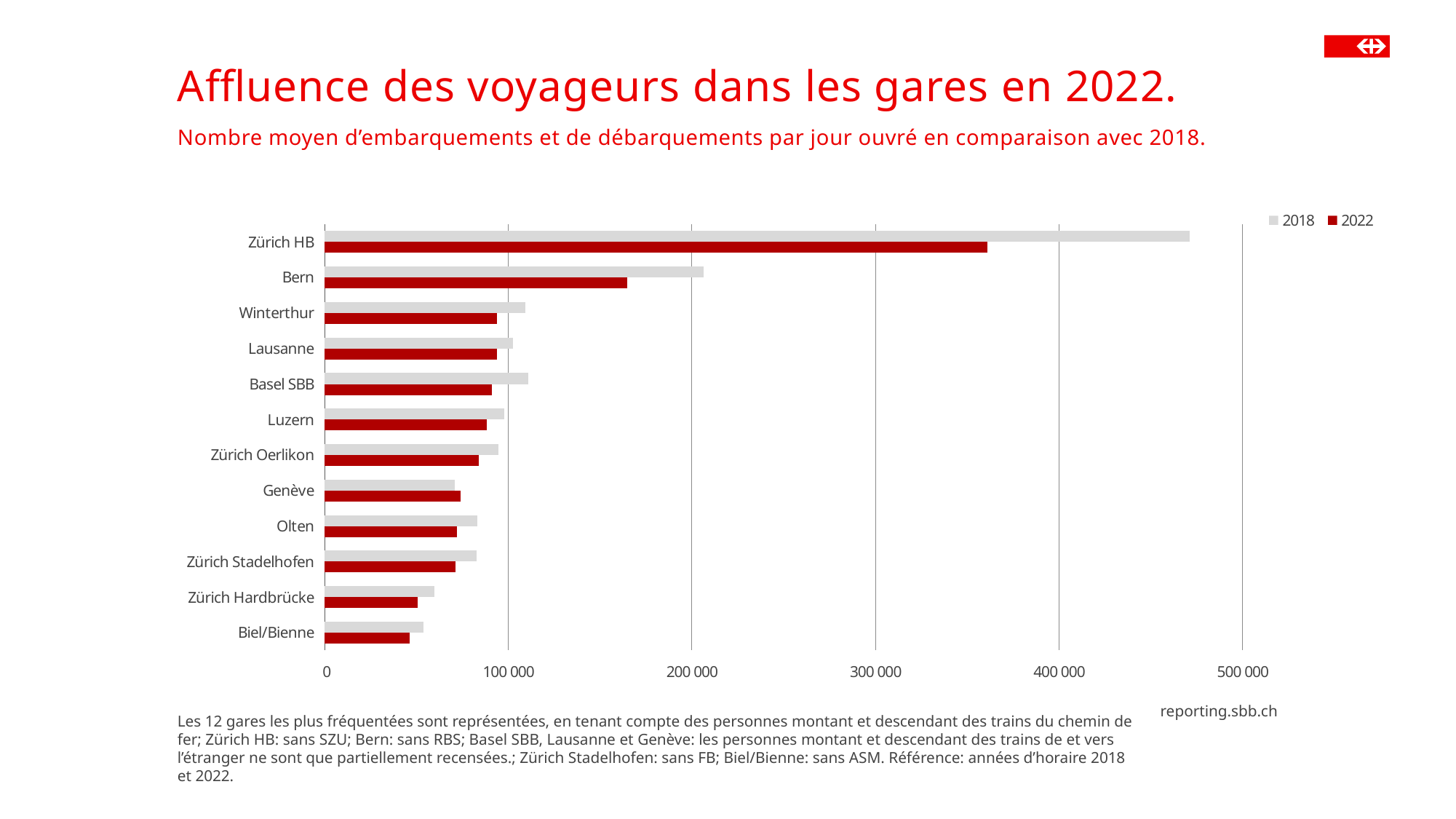
Which station has the lowest value for 2018? Biel/Bienne How many stations are listed on the chart? 12 How many series does the legend list? 2 Which station has the highest value for 2022? Zürich HB Is the 2022 value for Bern greater or less than 200 000? less Is the 2022 value for Zürich HB greater or less than 300 000? greater Which colour represents the 2022 series in the legend? Red What kind of chart is shown on the slide? Bar chart Which is larger for Bern: the 2018 value or the 2022 value? 2018 Is the 2018 value for Winterthur greater or less than 100 000? greater What is the title of the slide? Affluence des voyageurs dans les gares en 2022.